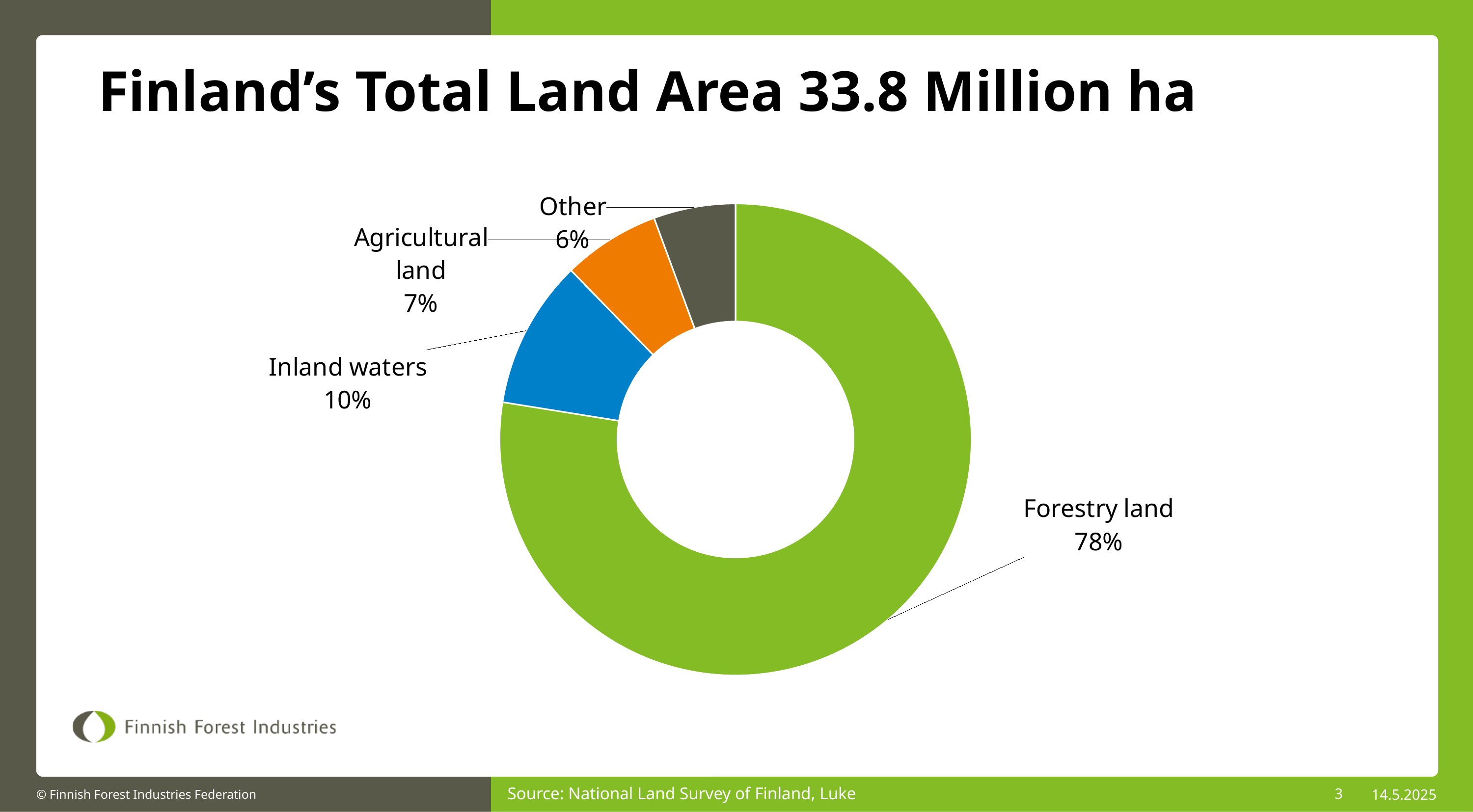
Which category has the smallest share of Finland's total land area? Other How many percentage points larger is the Inland waters share than the Agricultural land share? 3 What share of Finland's total land area is labelled Other? 6% What share of Finland's total land area is Agricultural land? 7% How many categories does the chart show? 4 What share of Finland's total land area is Forestry land? 78% Which category has the largest share of Finland's total land area? Forestry land Which has a larger share, Agricultural land or Other? Agricultural land How many percentage points larger is the Forestry land share than the Inland waters share? 68 What kind of chart is shown on the slide? Pie chart (doughnut) What share of Finland's total land area is Inland waters? 10% What is the title of the slide? Finland's Total Land Area 33.8 Million ha